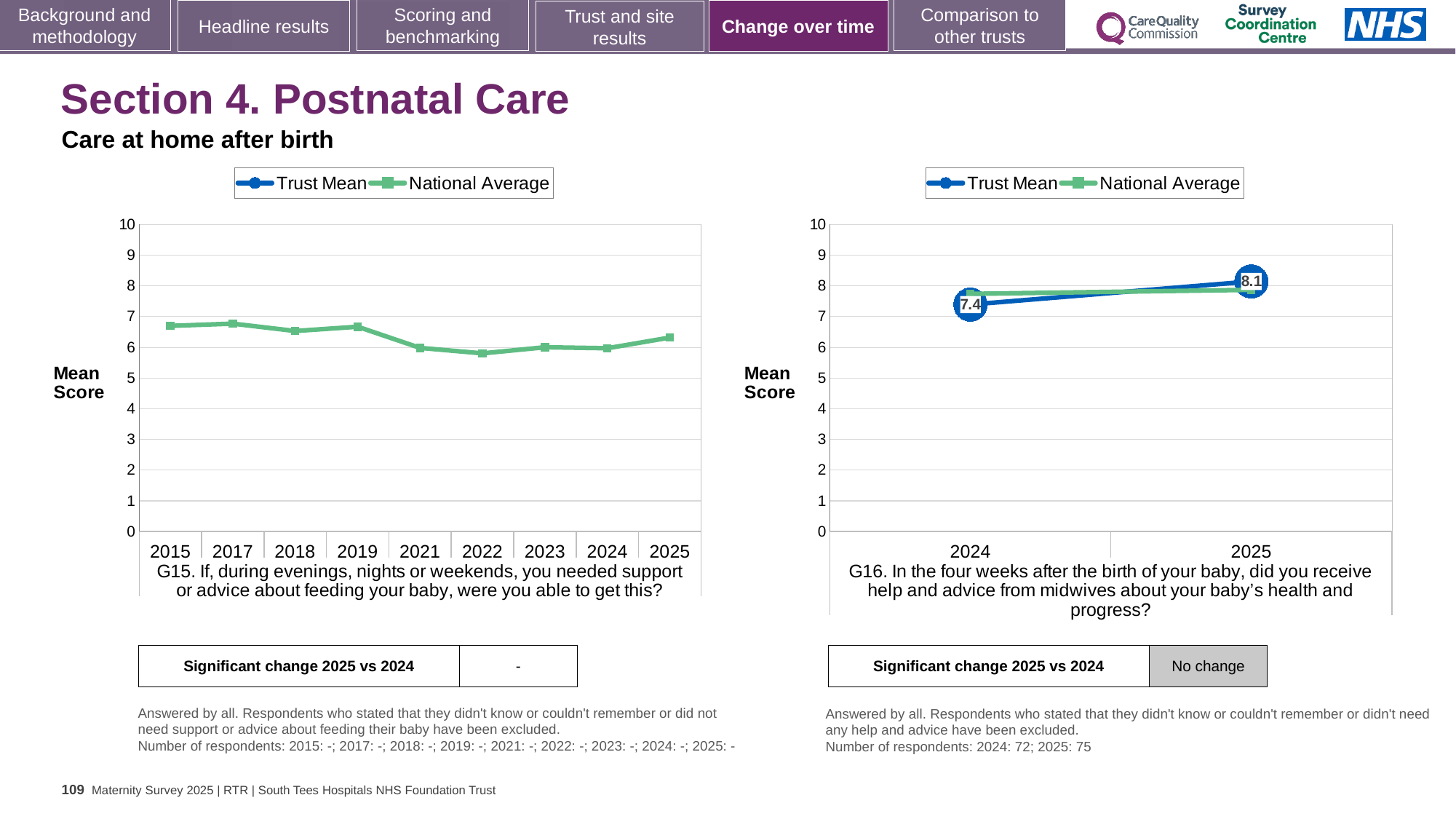
On the right chart (G16), what is the Trust Mean score for 2024? 7.4 On the right chart (G16), what is the Trust Mean score for 2025? 8.1 On the right chart (G16), does the Trust Mean rise or fall from 2024 to 2025? rise On the right chart (G16), is the National Average value for 2024 greater or less than 7? greater On the right chart (G16), how many years are shown on the x axis? 2 On the right chart (G16), by how much did the Trust Mean increase from 2024 to 2025? 0.7 How many series does the legend of the left chart (G15) list? 2 On the left chart (G15), is the National Average value for 2015 greater or less than 6? greater On the right chart (G16), which year has the higher Trust Mean, 2024 or 2025? 2025 On the left chart (G15), how many years are shown on the x axis? 9 What kind of chart is the right chart (G16)? line chart On the left chart (G15), is the National Average value for 2022 greater or less than 7? less